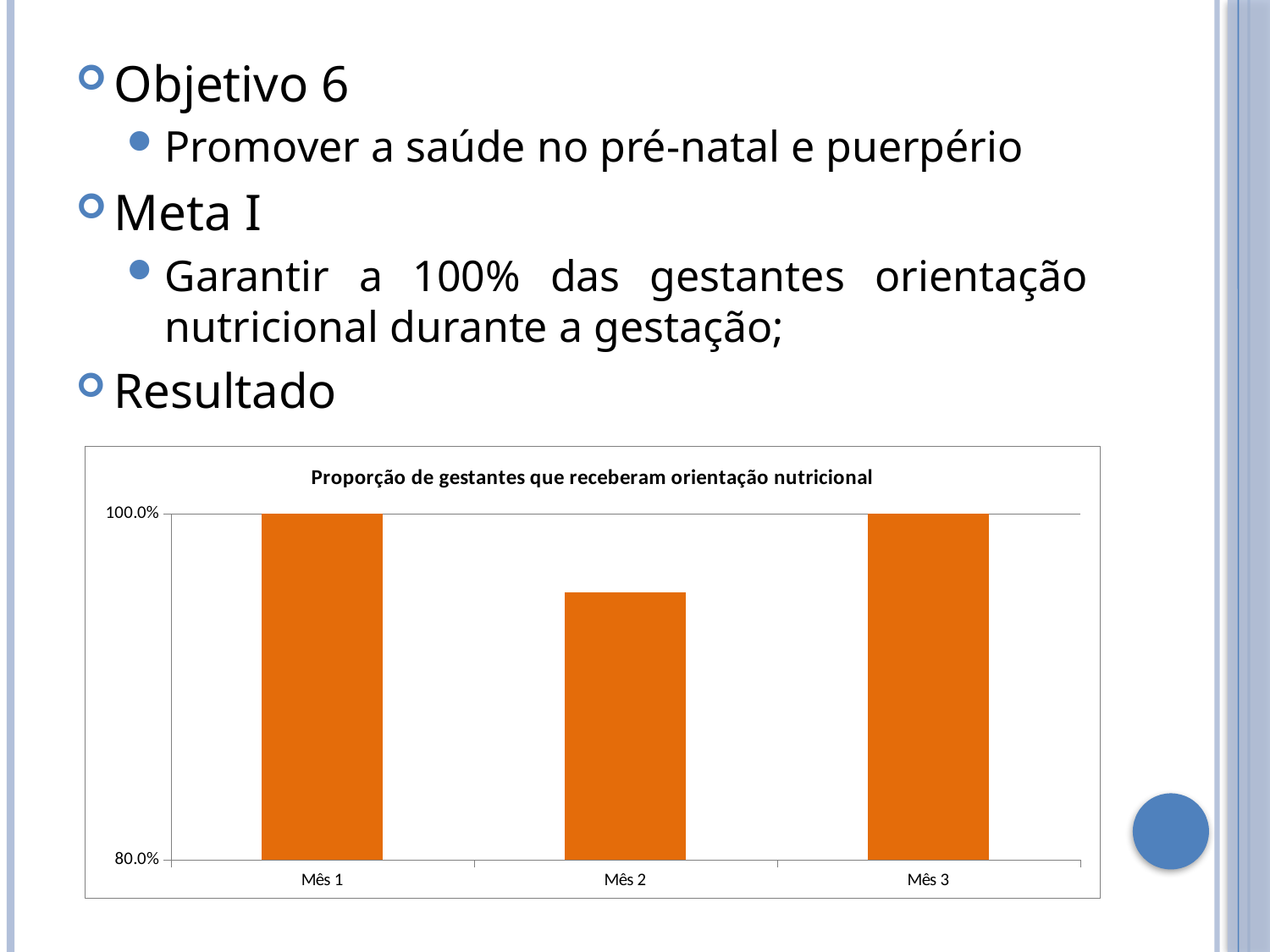
What is the value for Mês 1 in the chart? 100.0% What is the title of the chart? Proporção de gestantes que receberam orientação nutricional Which month has the lowest value in the chart? Mês 2 Does the value rise or fall from Mês 1 to Mês 2? fall How many categories (months) are shown on the x axis of the chart? 3 Is the value for Mês 2 greater or less than 100.0%? less What colour are the bars in the chart? orange Which is larger, the value for Mês 1 or the value for Mês 2? Mês 1 What kind of chart is shown on the slide? bar chart Is the value for Mês 2 greater or less than 80.0%? greater What is the value for Mês 3 in the chart? 100.0% Which is larger, the value for Mês 2 or the value for Mês 3? Mês 3